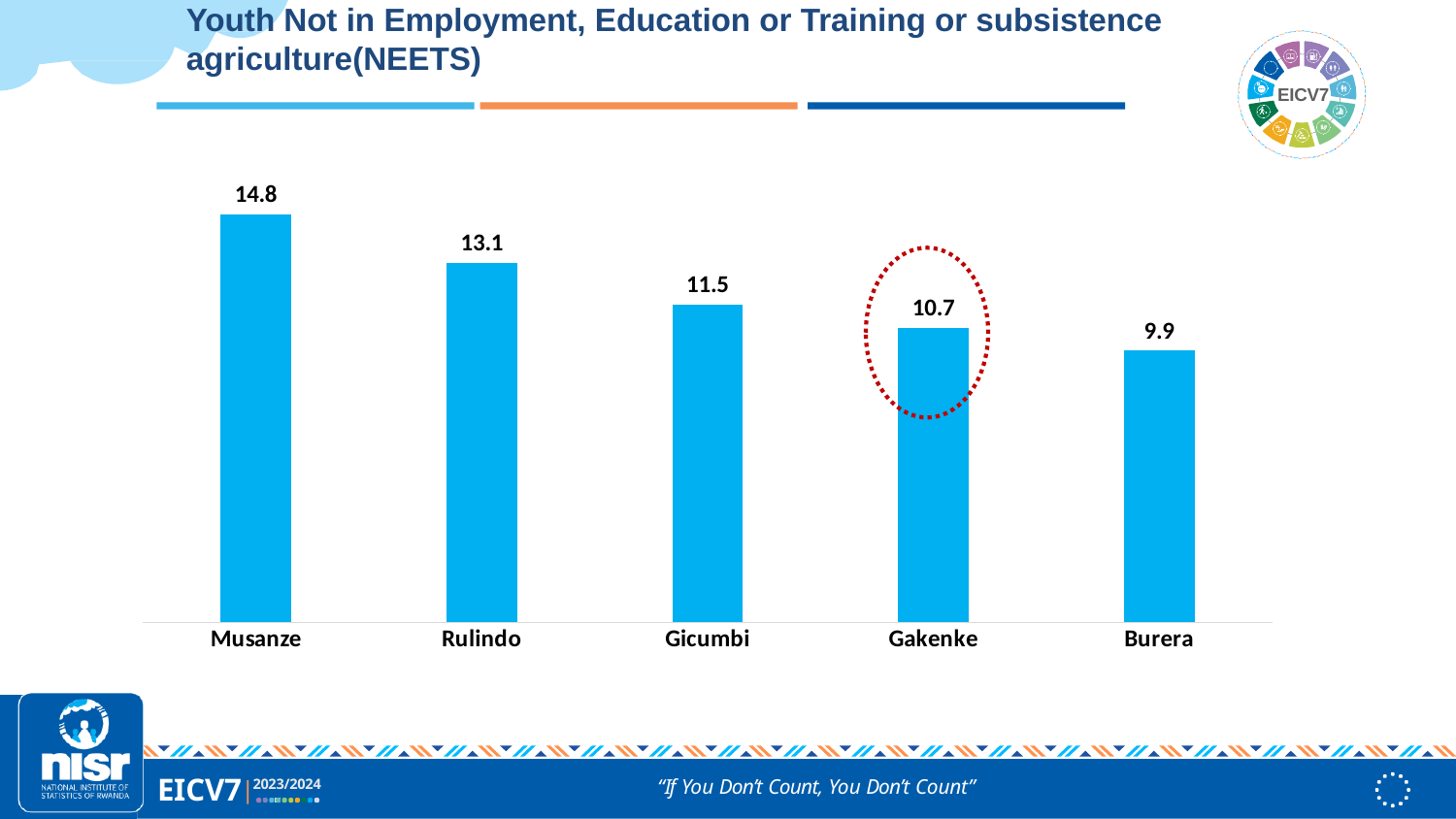
What is the difference between the values for Rulindo and Gicumbi? 1.6 What is the value for Gakenke? 10.7 Which district's bar is highlighted with a red dotted circle? Gakenke What kind of chart is shown on the slide? Bar chart What is the value for Burera? 9.9 Which district has the lowest value? Burera Do the values rise or fall from left to right across the districts? Fall How many districts are shown in the chart? 5 What is the difference between the values for Musanze and Burera? 4.9 Which district has the highest value? Musanze Which is larger, the value for Gicumbi or the value for Gakenke? Gicumbi What is the value for Musanze? 14.8